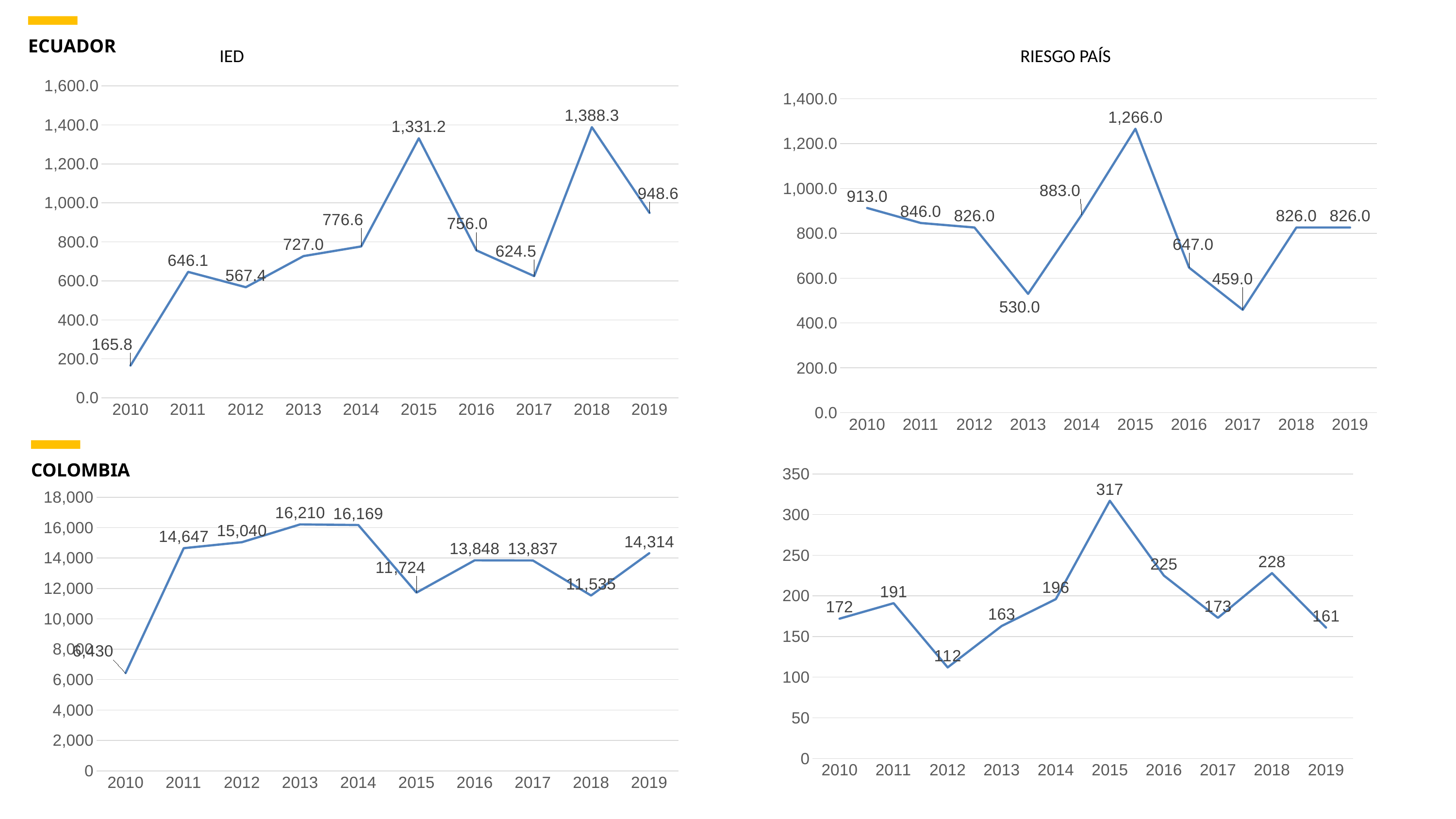
In the Colombia IED chart (bottom left), which year has the lowest value? 2010 In the Ecuador IED chart (top left), which year has the highest value? 2018 In the Colombia RIESGO PAÍS chart (bottom right), what is the value for 2012? 112 How many years are plotted on the x axis of the Colombia RIESGO PAÍS chart (bottom right)? 10 In the Ecuador RIESGO PAÍS chart (top right), what is the value for 2017? 459.0 In the Ecuador RIESGO PAÍS chart (top right), which year has the highest value? 2015 In the Colombia RIESGO PAÍS chart (bottom right), what is the difference between the 2018 value and the 2017 value? 55 In the Ecuador RIESGO PAÍS chart (top right), what is the difference between the 2015 value and the 2013 value? 736.0 In the Ecuador IED chart (top left), which is larger, the value for 2011 or the value for 2012? 2011 In the Ecuador IED chart (top left), which year has the lowest value? 2010 In the Ecuador IED chart (top left), what is the value for 2015? 1,331.2 In the Colombia IED chart (bottom left), what is the value for 2013? 16,210